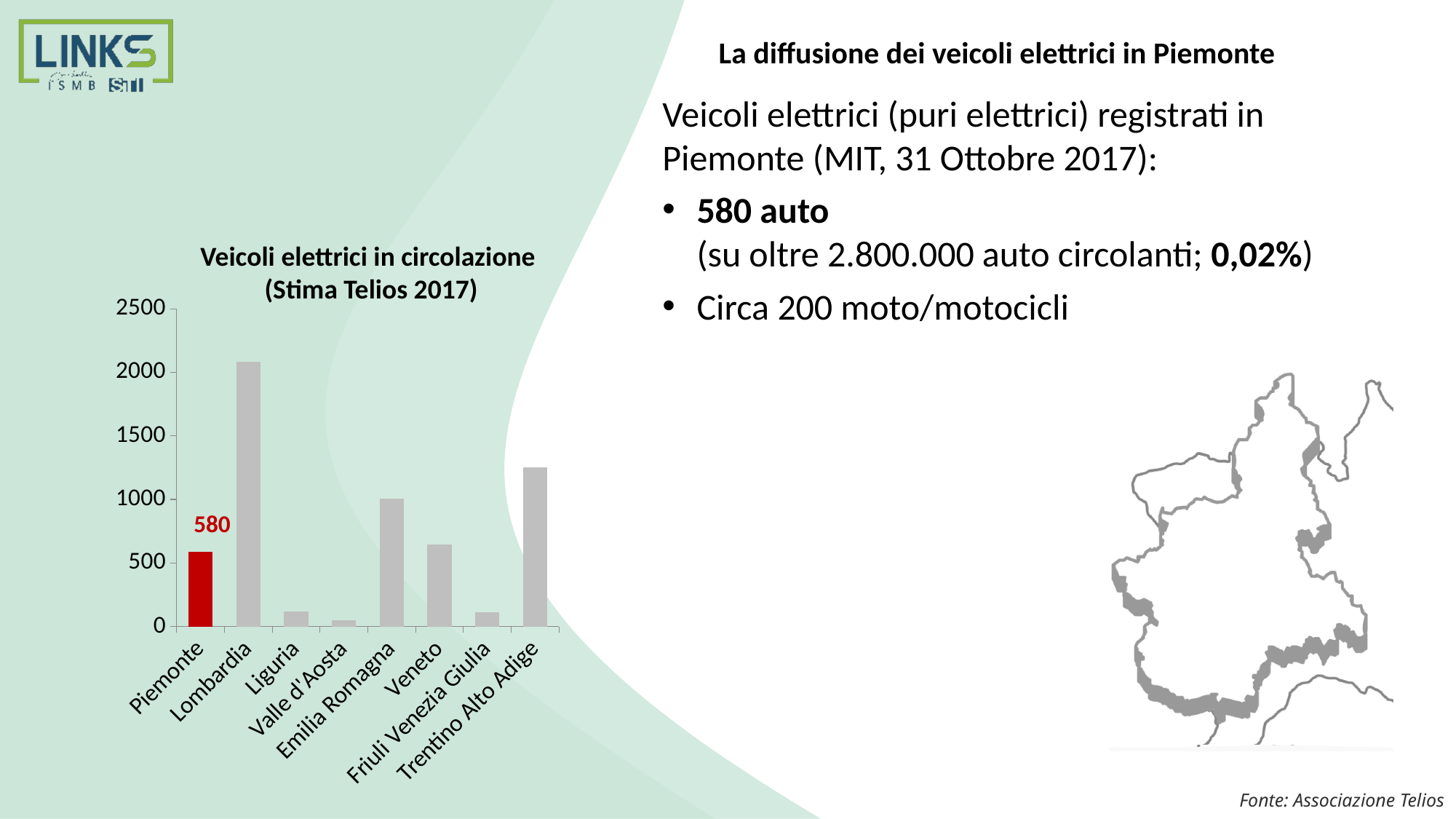
Is the value for Trentino Alto Adige greater or less than 1000? greater Is the value for Lombardia greater or less than 2000? greater Which region's bar is highlighted in red in the chart? Piemonte Which has a larger value, Trentino Alto Adige or Emilia Romagna? Trentino Alto Adige How many regions are shown in the chart? 8 Which region has the highest number of electric vehicles in the chart? Lombardia Which has a larger value, Veneto or Piemonte? Veneto Which region has the lowest number of electric vehicles in the chart? Valle d'Aosta What is the title of the chart? Veicoli elettrici in circolazione (Stima Telios 2017) What type of chart is shown on the slide? bar chart Is the value for Veneto greater or less than 1000? less What is the value for Piemonte in the chart? 580